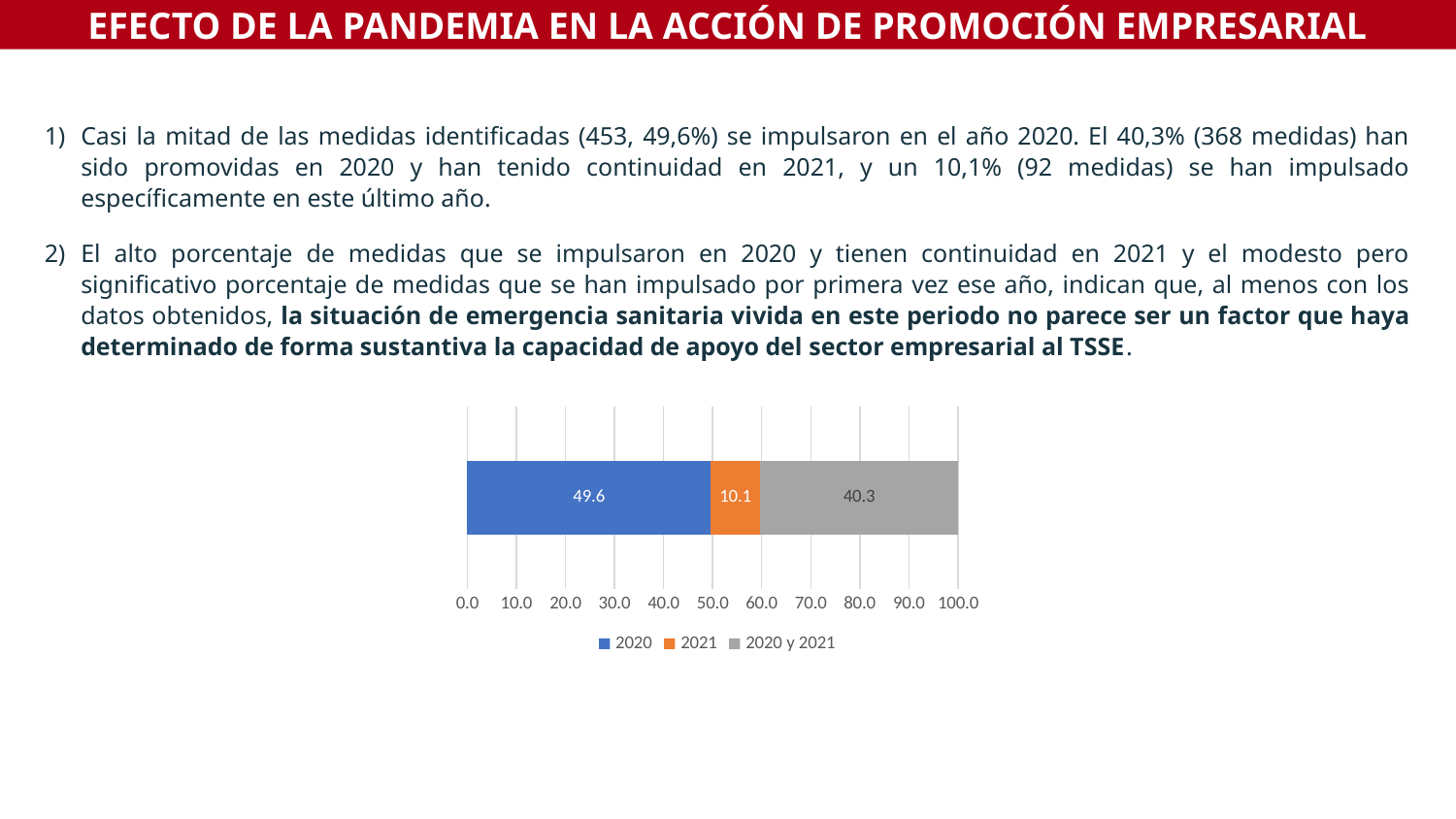
Which series has the largest value in the stacked bar? 2020 What kind of chart is shown on the slide? Stacked bar chart What is the total of the stacked bar? 100.0 Which is larger, the value for 2020 or the value for '2020 y 2021'? 2020 What is the value for the 2020 series in the stacked bar? 49.6 What is the value for the 2021 series in the stacked bar? 10.1 Which series has the smallest value in the stacked bar? 2021 How many series does the legend list? 3 What colour represents the 2021 series in the chart? Orange What is the value for the '2020 y 2021' series in the stacked bar? 40.3 What is the difference between the 2020 value and the '2020 y 2021' value? 9.3 What is the difference between the '2020 y 2021' value and the 2021 value? 30.2